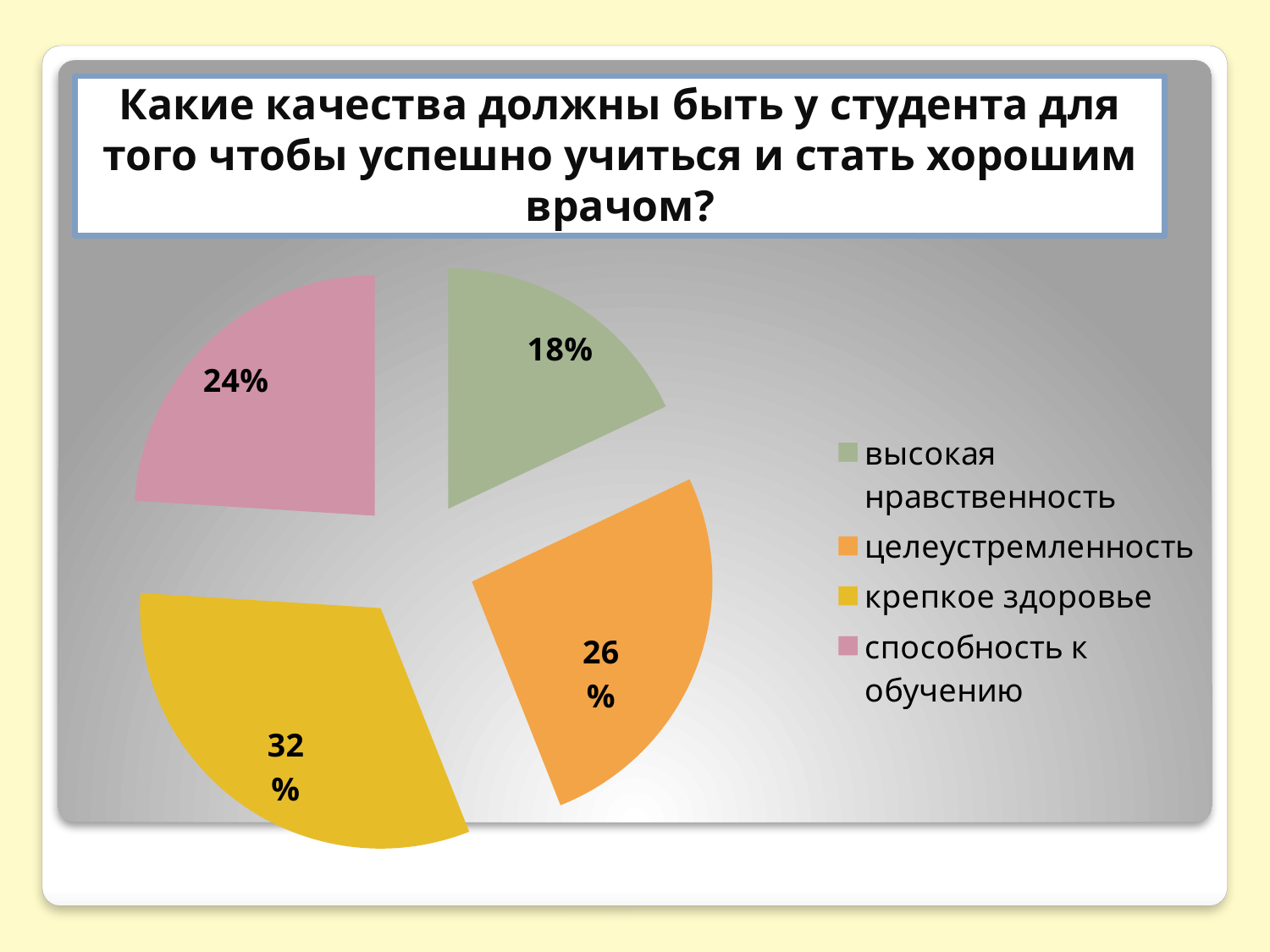
What is the difference in percentage points between "крепкое здоровье" and "высокая нравственность"? 14 What colour is the slice for "способность к обучению"? pink How many entries does the legend list? 4 What percentage is shown for "целеустремленность"? 26% What percentage is shown for "способность к обучению"? 24% Which is larger: the share for "целеустремленность" or the share for "способность к обучению"? целеустремленность How many slices does the pie chart have? 4 Which quality has the smallest share of the pie? высокая нравственность What percentage is shown for "высокая нравственность"? 18% Which quality has the largest share of the pie? крепкое здоровье What percentage is shown for "крепкое здоровье"? 32% What kind of chart is shown on the slide? pie chart